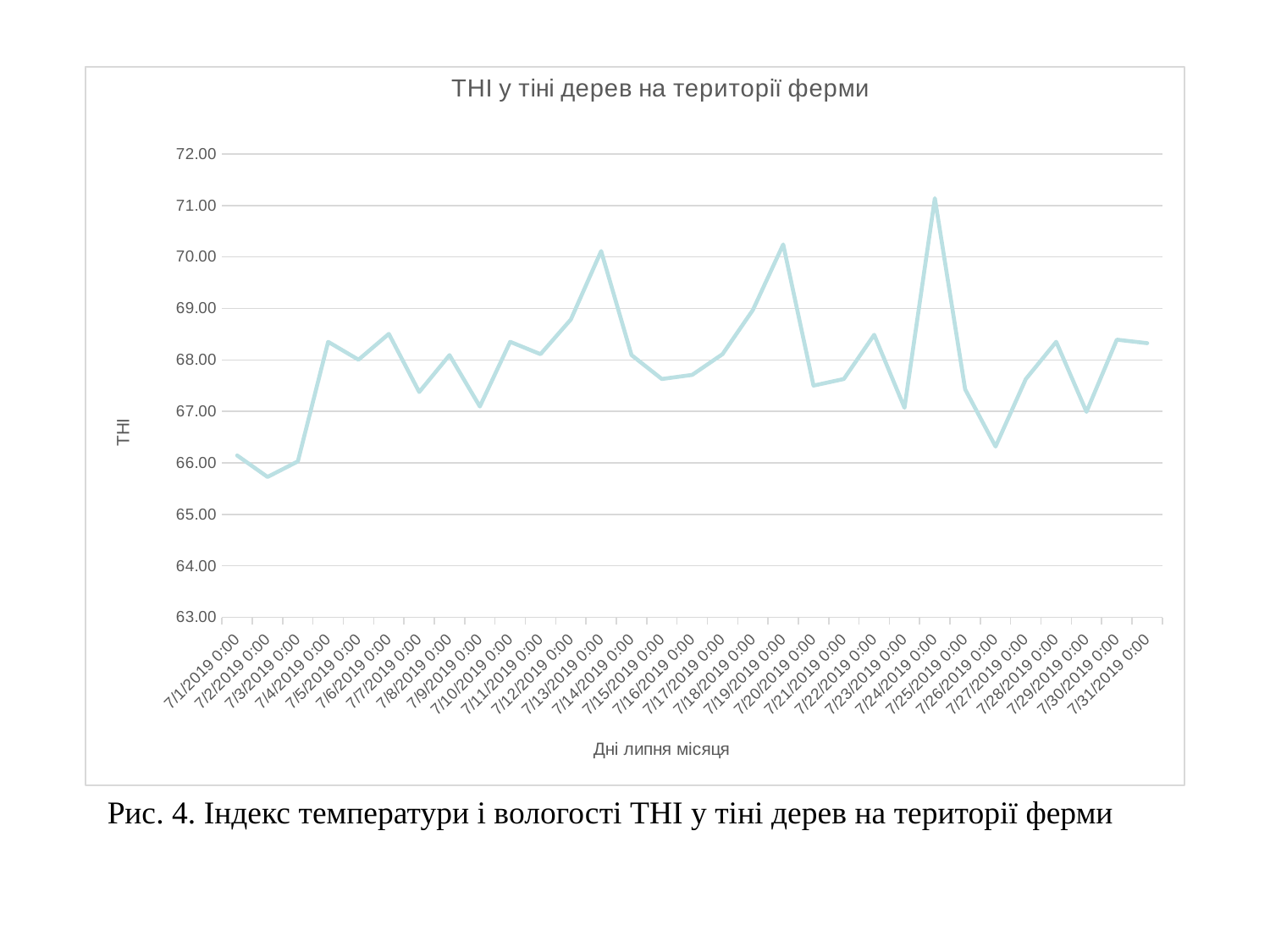
On which date does the THI reach its highest value? 7/24/2019 0:00 Is the THI value for 7/25/2019 0:00 greater or less than 70.00? less Which date has the higher THI value, 7/4/2019 0:00 or 7/9/2019 0:00? 7/4/2019 0:00 Is the THI value for 7/26/2019 0:00 greater or less than 67.00? less Is the THI value for 7/13/2019 0:00 greater or less than 69.00? greater On which date does the THI reach its lowest value? 7/2/2019 0:00 What kind of chart is shown on the slide? line chart What is the label of the x axis? Дні липня місяця How many days (data points) are plotted on the chart? 31 Does the THI rise or fall from 7/25/2019 0:00 to 7/26/2019 0:00? fall What is the title of the chart? THI у тіні дерев на території ферми